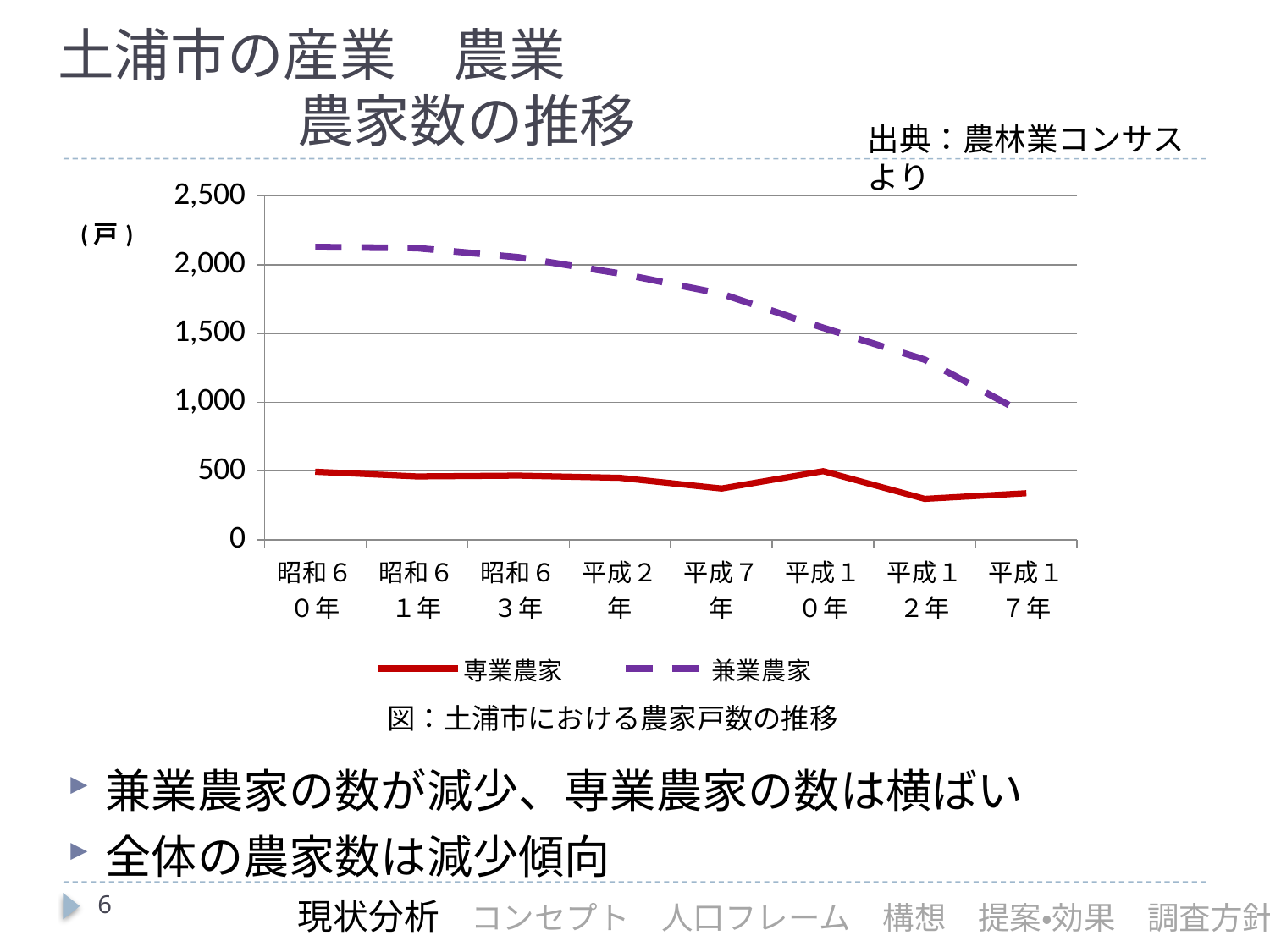
How many years are plotted along the x axis? 8 Is the value for 専業農家 in 平成12年 greater or less than 500? less Is the value for 兼業農家 in 昭和60年 greater or less than 2,000? greater Which series is drawn with a dashed line? 兼業農家 Is the value for 専業農家 in 平成7年 greater or less than 500? less What kind of chart is shown on the slide? line chart In which year is the value for 兼業農家 lowest? 平成17年 Which series has the larger value in 平成17年, 専業農家 or 兼業農家? 兼業農家 How many series does the legend list? 2 In which year is the value for 専業農家 lowest? 平成12年 Does the value for 兼業農家 rise or fall from 昭和60年 to 平成17年? fall